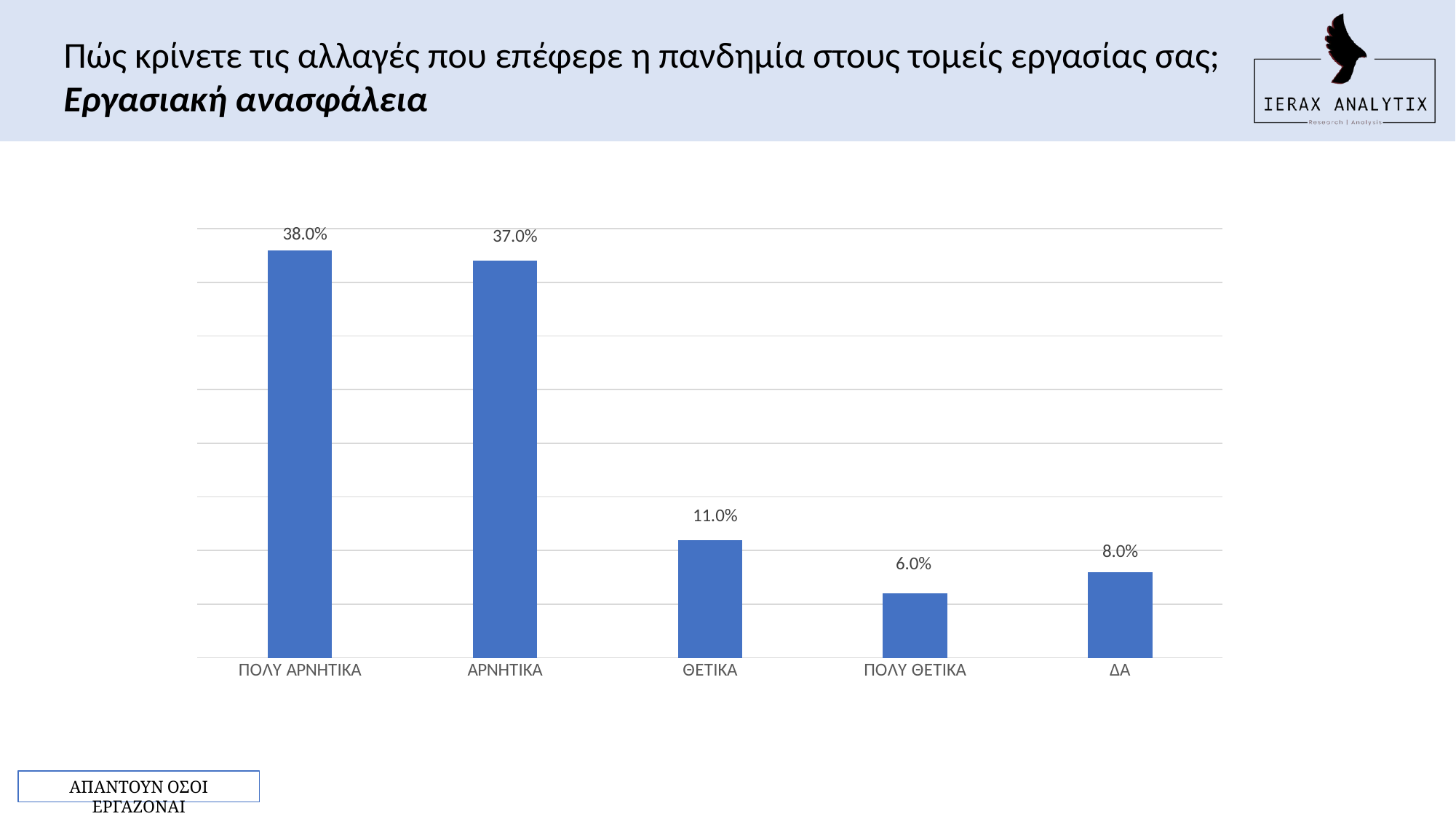
What is the difference between the values for ΠΟΛΥ ΑΡΝΗΤΙΚΑ and ΘΕΤΙΚΑ? 27.0% What is the subtitle of the slide, shown in bold italics under the question? Εργασιακή ανασφάλεια Which category has the lowest value? ΠΟΛΥ ΘΕΤΙΚΑ What is the value for ΑΡΝΗΤΙΚΑ? 37.0% How many categories are shown in the chart? 5 Which is larger, the value for ΔΑ or the value for ΠΟΛΥ ΘΕΤΙΚΑ? ΔΑ What is the value for ΠΟΛΥ ΑΡΝΗΤΙΚΑ? 38.0% What is the value for ΔΑ? 8.0% Which category has the highest value? ΠΟΛΥ ΑΡΝΗΤΙΚΑ What kind of chart is shown on the slide? Bar chart What is the value for ΘΕΤΙΚΑ? 11.0% What is the value for ΠΟΛΥ ΘΕΤΙΚΑ? 6.0%